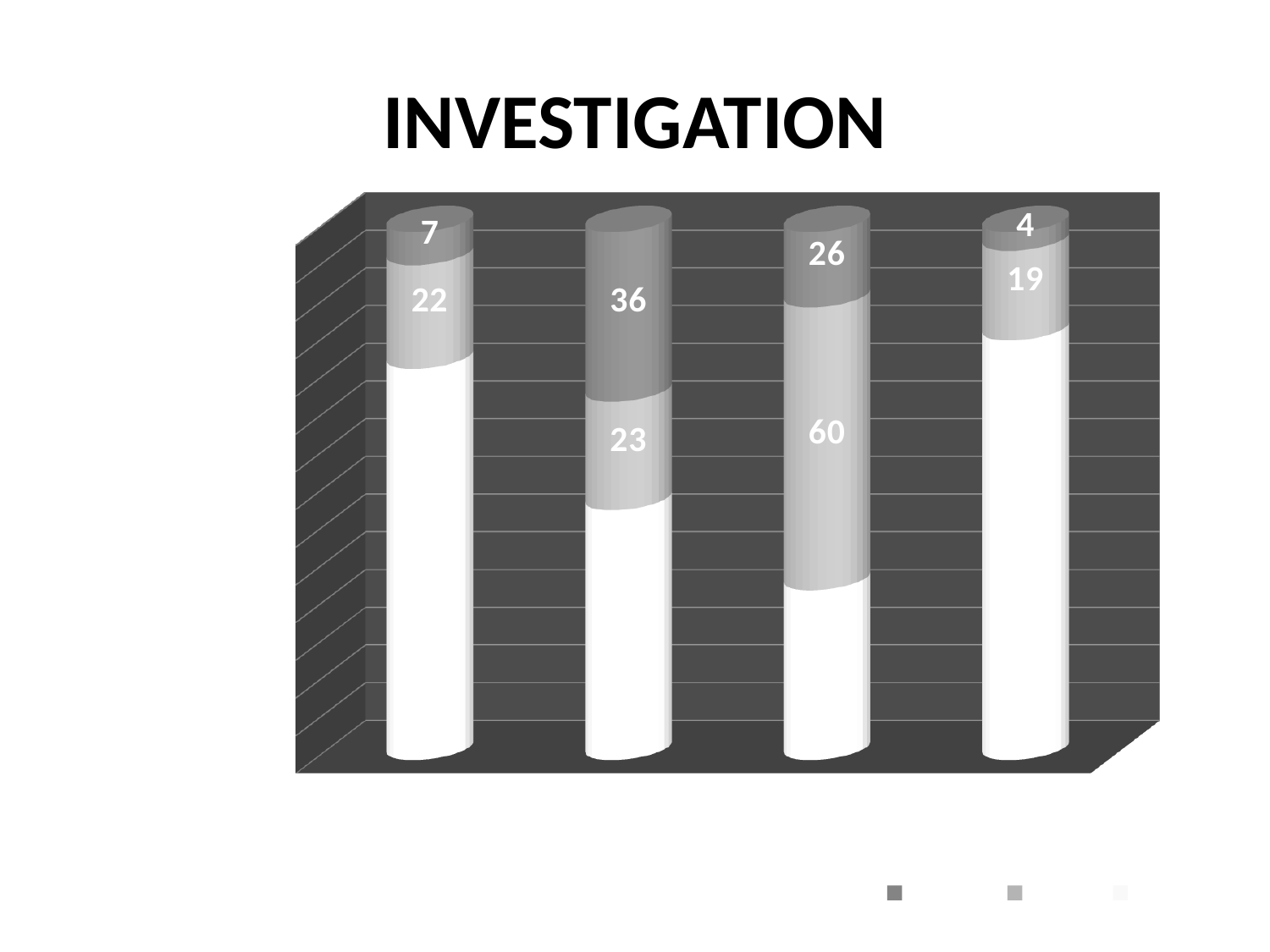
Which bar has the largest dark grey top segment? The second bar from the left What kind of chart is shown on the slide? Stacked bar chart What is the value of the light grey middle segment of the first bar from the left? 22 How many bars are plotted in the chart? 4 What is the value of the light grey middle segment of the third bar from the left? 60 What is the value of the dark grey top segment of the first bar from the left? 7 What is the difference between the dark grey segment of the second bar (36) and the dark grey segment of the first bar (7)? 29 What is the value of the dark grey top segment of the second bar from the left? 36 What is the title of the chart? INVESTIGATION How many series does the legend list? 3 What is the value of the dark grey top segment of the fourth bar from the left? 4 Which bar has the smallest light grey middle segment? The fourth bar from the left